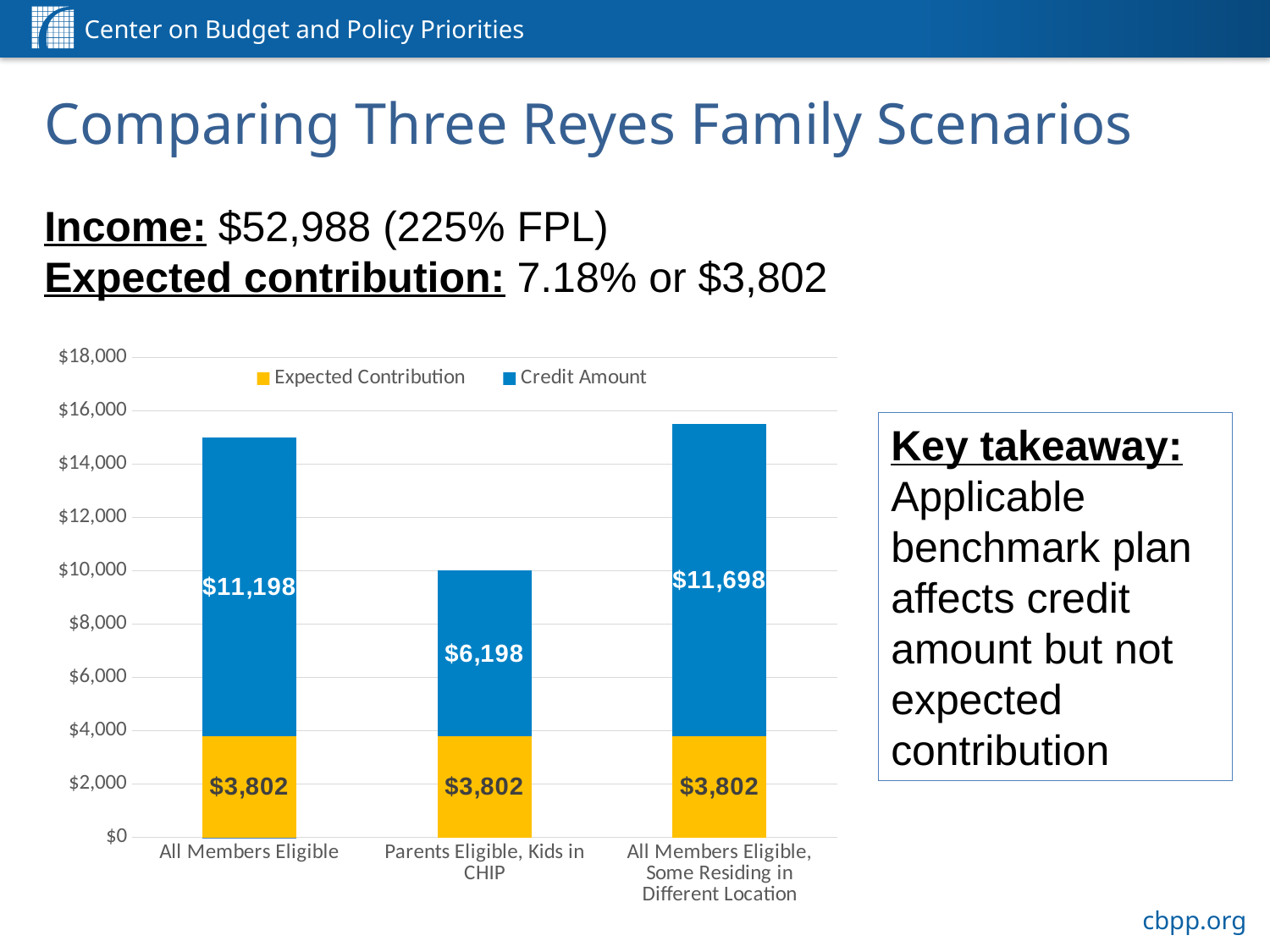
Which scenario has the highest Credit Amount? All Members Eligible, Some Residing in Different Location What is the Credit Amount for the "All Members Eligible" scenario? $11,198 How many scenarios (categories) are shown on the x axis? 3 What is the Credit Amount for the "All Members Eligible, Some Residing in Different Location" scenario? $11,698 What is the difference in Credit Amount between "All Members Eligible, Some Residing in Different Location" and "All Members Eligible"? $500 What is the Expected Contribution for the "Parents Eligible, Kids in CHIP" scenario? $3,802 Which scenario has the lowest Credit Amount? Parents Eligible, Kids in CHIP What is the total of the stacked bar for "Parents Eligible, Kids in CHIP"? $10,000 What is the total of the stacked bar for "All Members Eligible"? $15,000 How many series does the legend list? 2 What kind of chart is shown on the slide? Stacked bar chart What is the Credit Amount for the "Parents Eligible, Kids in CHIP" scenario? $6,198